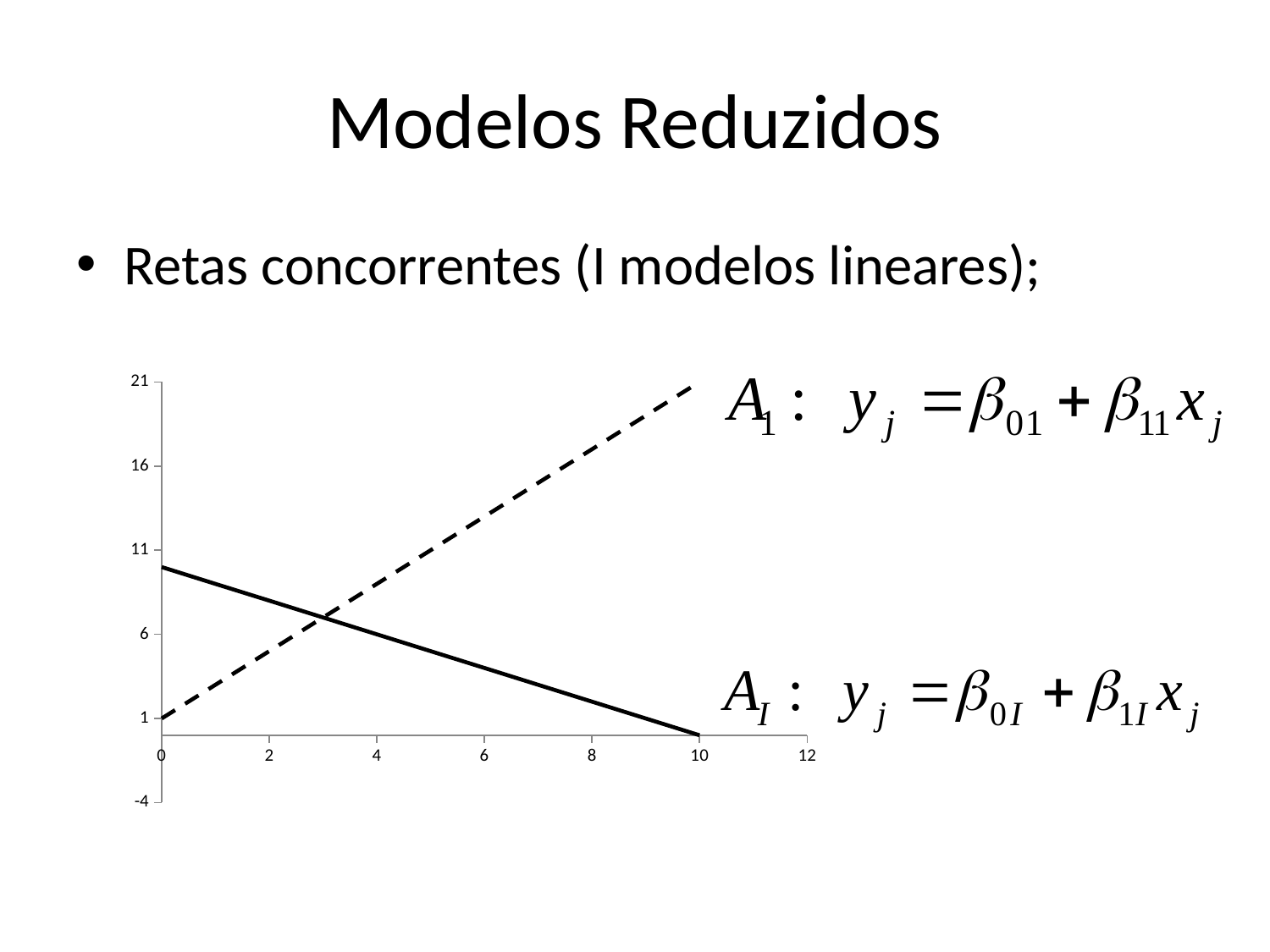
At x = 0, which line has the higher value, the dashed line or the solid line? the solid line Is the value of the dashed line at x = 10 greater or less than 16? greater At x = 8, which line has the higher value, the dashed line or the solid line? the dashed line How many lines are plotted on the chart? 2 Is the value of the solid line at x = 8 greater or less than 6? less What kind of chart is shown on the slide? line chart Is the value of the dashed line at x = 0 greater or less than 6? less Does the dashed line rise or fall as x increases? rises What is the highest value shown on the x axis? 12 Does the solid line rise or fall as x increases? falls What is the highest value shown on the y axis? 21